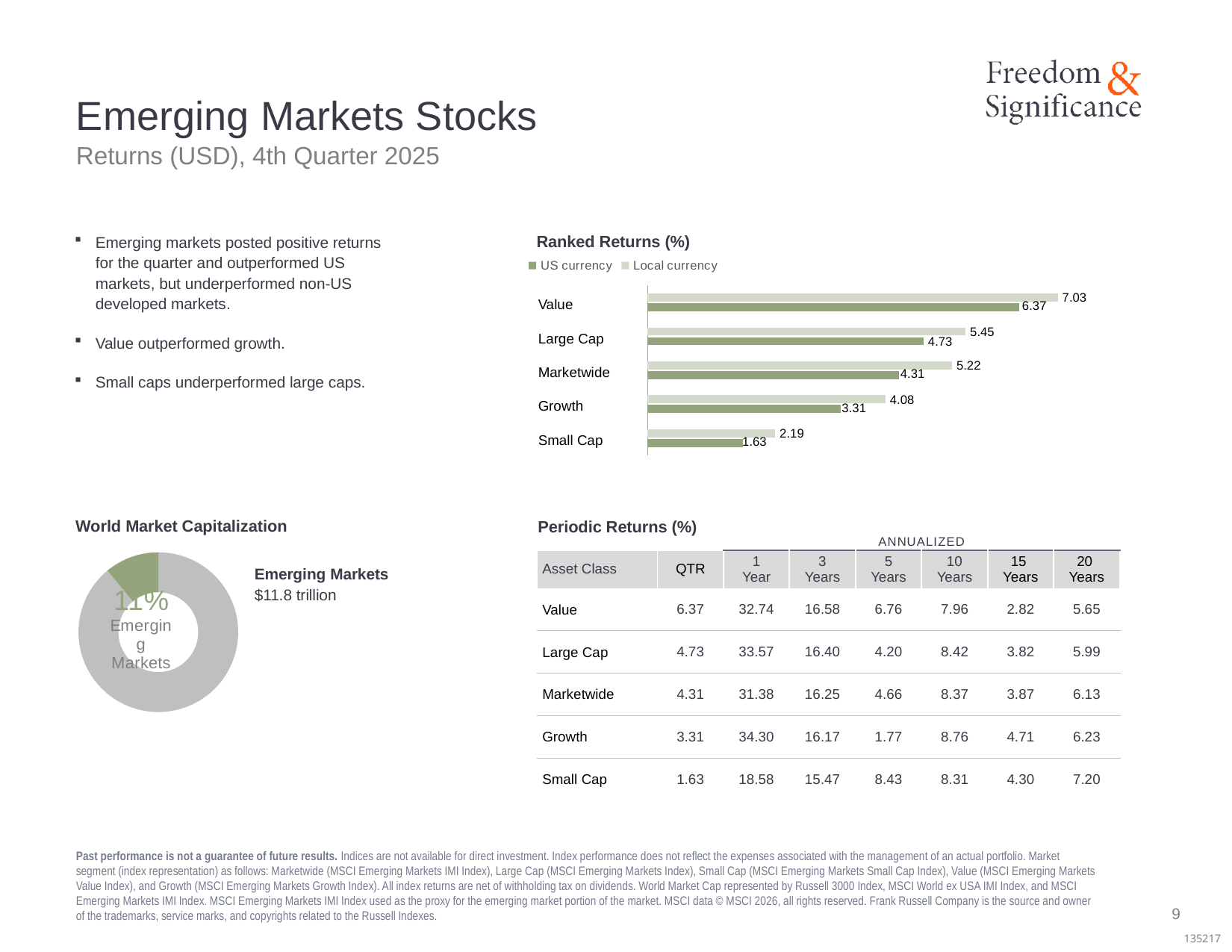
In the Ranked Returns (%) chart, which category has the highest US currency return? Value How many categories are shown in the Ranked Returns (%) chart? 5 In the Ranked Returns (%) chart, which is larger: the US currency return for Growth or the US currency return for Marketwide? Marketwide In the Ranked Returns (%) chart, what is the US currency return for Value? 6.37 In the Ranked Returns (%) chart, what is the difference between the Local currency and US currency returns for Large Cap? 0.72 What kind of chart is the Ranked Returns (%) chart? Bar chart In the World Market Capitalization chart, what share of the pie is Emerging Markets? 11% How many series does the legend of the Ranked Returns (%) chart list? 2 In the Ranked Returns (%) chart, what is the Local currency return for Small Cap? 2.19 In the Ranked Returns (%) chart, which category has the lowest Local currency return? Small Cap What are the two series named in the legend of the Ranked Returns (%) chart? US currency and Local currency In the Ranked Returns (%) chart, what is the Local currency return for Marketwide? 5.22